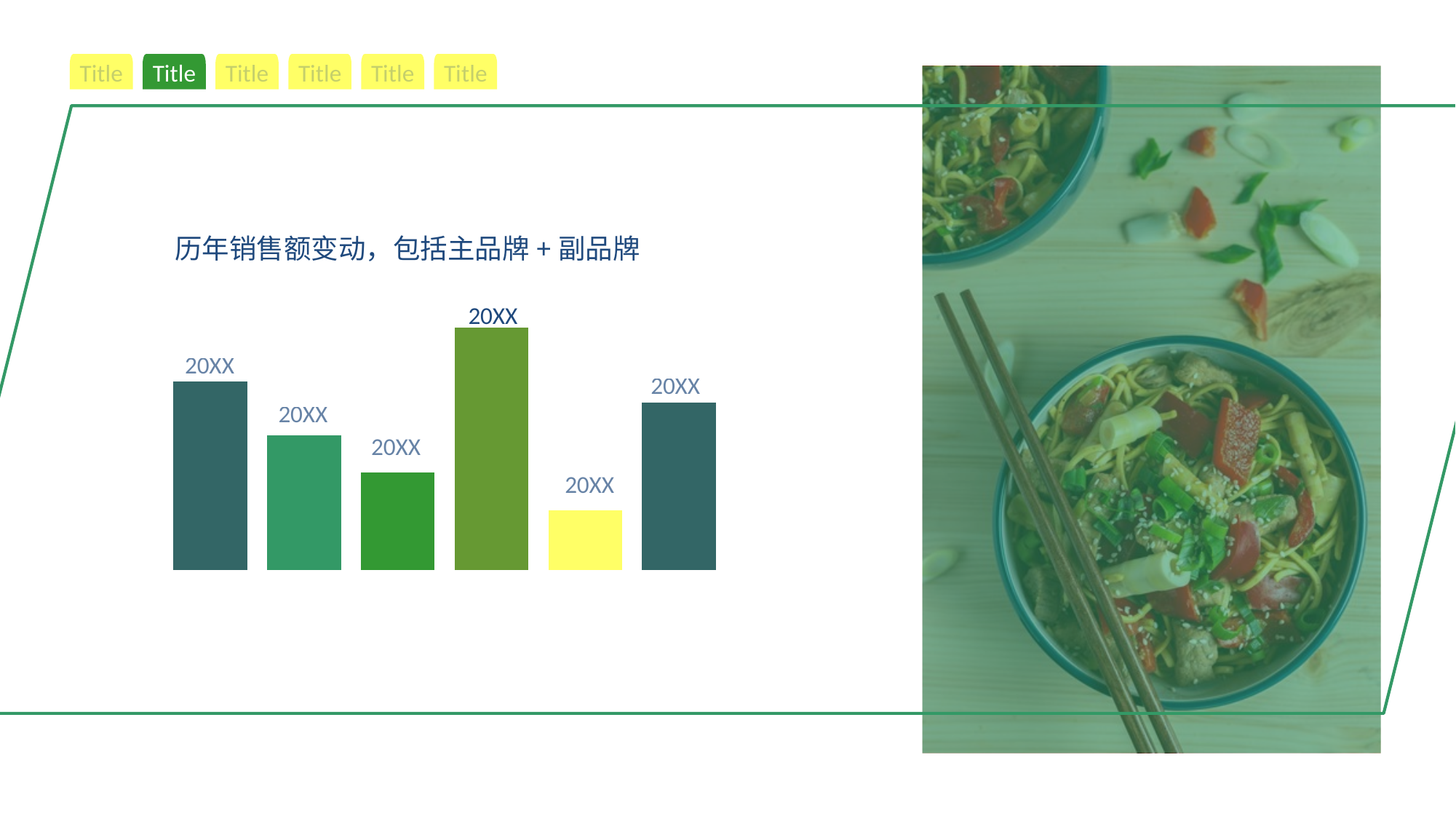
Which bar in the chart is the shortest, counting from the left? the fifth bar What colour is the fifth bar from the left in the chart? yellow Which bar in the chart is the tallest, counting from the left? the fourth bar Which is taller, the first bar from the left or the second bar? the first bar What kind of chart is shown on the slide? bar chart Which is taller, the third bar from the left or the sixth bar? the sixth bar Which is taller, the second bar from the left or the third bar? the second bar What is the title text shown above the chart? 历年销售额变动，包括主品牌 + 副品牌 How many bars does the chart contain? 6